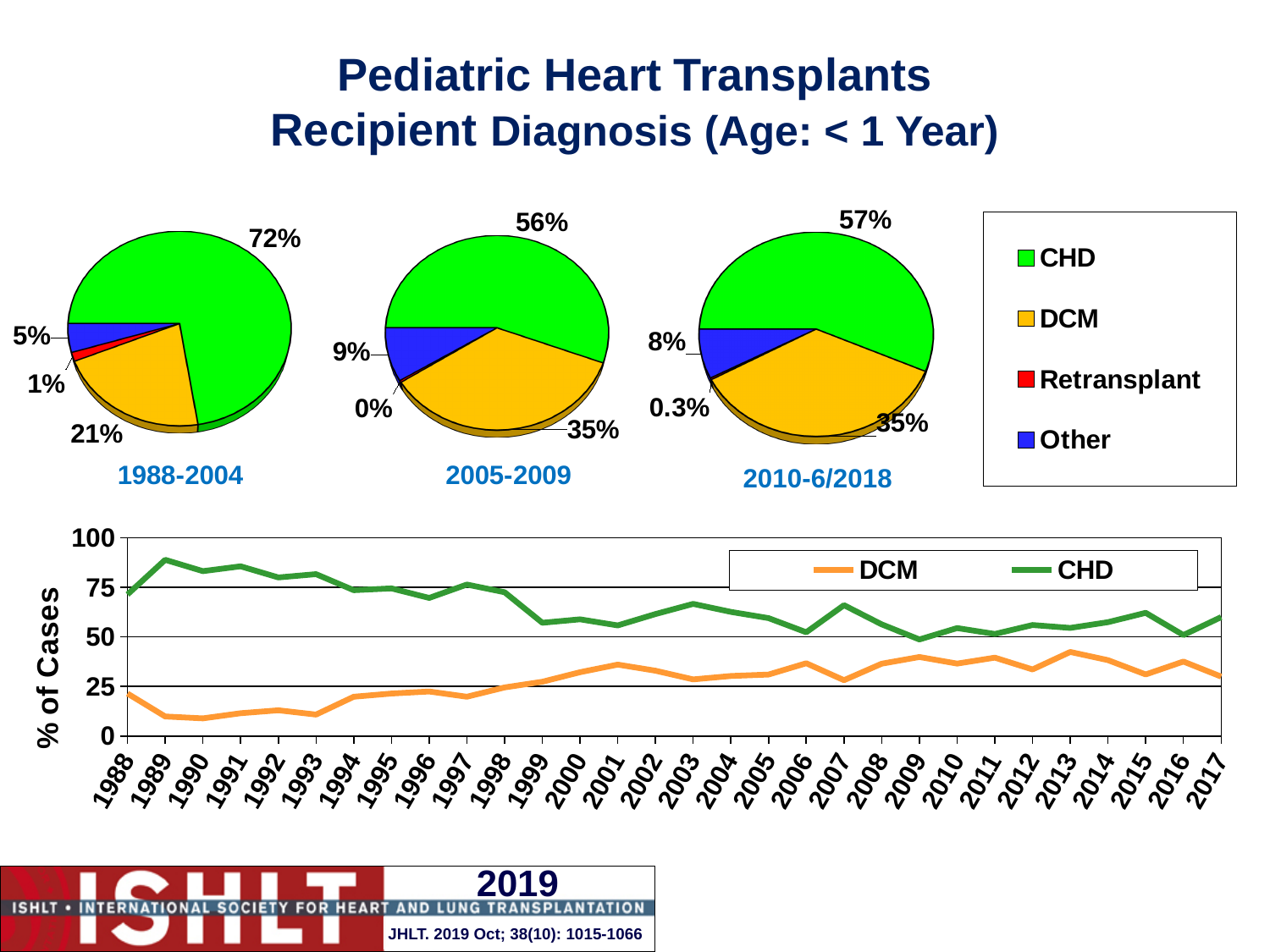
In the 2005-2009 pie chart, what share of cases is DCM? 35% In the line chart at the bottom, is the CHD value for 1989 greater or less than 75? greater In the 1988-2004 pie chart, which diagnosis has the smallest share? Retransplant In the 2005-2009 pie chart, what is the difference between the CHD share and the DCM share? 21% In the 2010-6/2018 pie chart, what share of cases is Retransplant? 0.3% In the 2010-6/2018 pie chart, which diagnosis has the largest share? CHD How many series does the legend of the line chart at the bottom list? 2 Is the Other share larger in the 1988-2004 pie chart or in the 2005-2009 pie chart? 2005-2009 What kind of chart is the chart at the bottom of the slide? Line chart In the 1988-2004 pie chart, what share of cases is CHD? 72% How many diagnosis categories does the pie chart legend list? 4 In the line chart at the bottom, does the CHD line generally rise or fall from 1988 to 2017? Fall